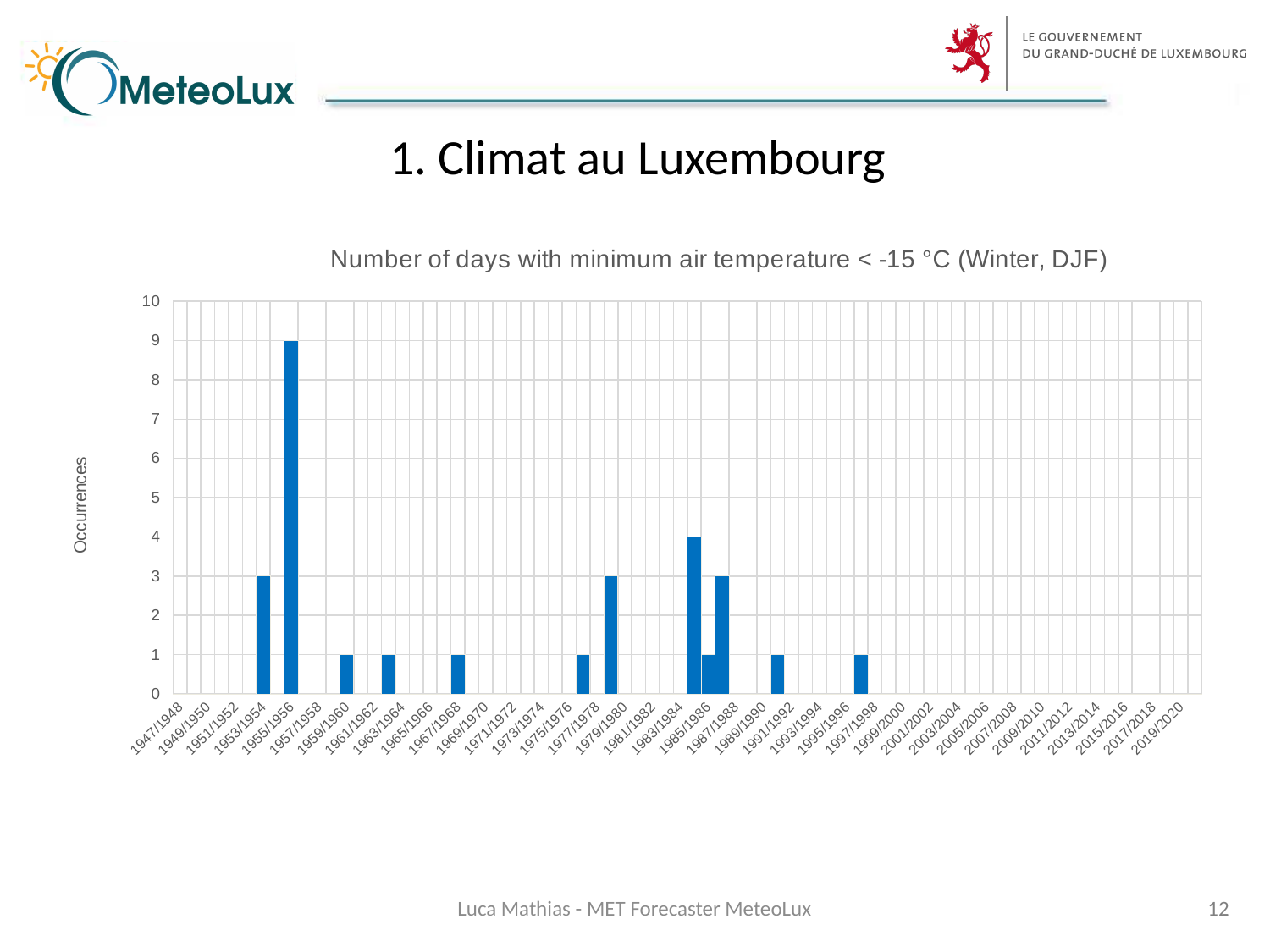
What is the difference in occurrences between the winters 1955/1956 and 1953/1954? 6 Is the value for the winter 1955/1956 greater or less than 5? greater How many occurrences are shown for the winter 1955/1956? 9 How many bars (winters with at least one occurrence) are shown in the chart? 12 What is the highest number of occurrences shown by any bar in the chart? 9 What is the label of the vertical axis? Occurrences What type of chart is shown on the slide? Bar chart Which winter has more occurrences, 1953/1954 or 1955/1956? 1955/1956 Do the occurrences generally increase or decrease over the period shown on the x axis? Decrease Which winter has the highest number of occurrences? 1955/1956 What is the title of the chart? Number of days with minimum air temperature < -15 °C (Winter, DJF) How many occurrences are shown for the winter 1953/1954? 3